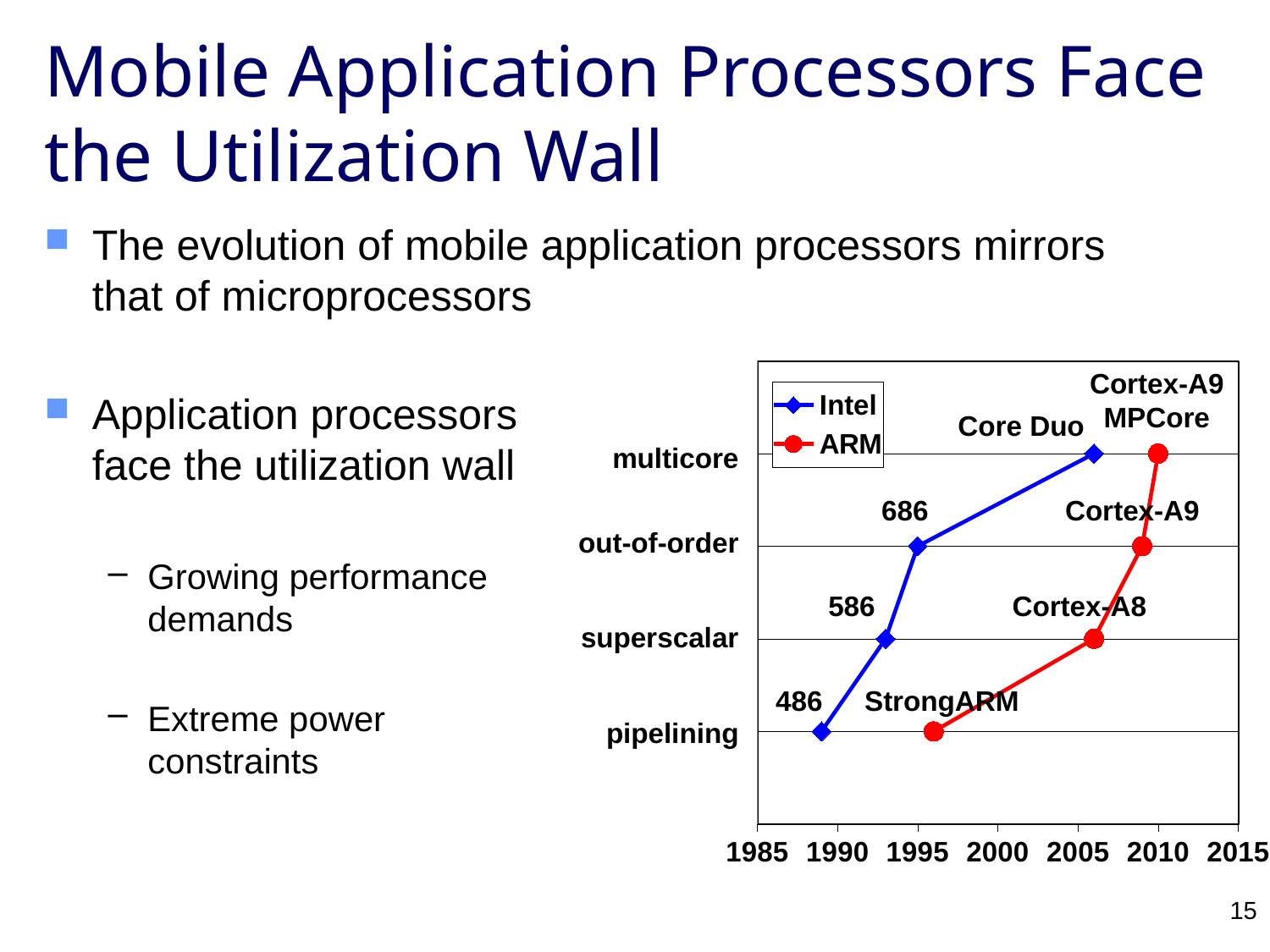
Which series reached the multicore level earlier, Intel or ARM? Intel How many data points are plotted for the ARM series? 4 Is the year for the ARM Cortex-A8 point greater or less than 2005? greater Which Intel processor is plotted at the superscalar level? 586 Is the year for the Intel 486 point greater or less than 1990? less Which Intel processor is plotted at the multicore level? Core Duo What kind of chart is shown on the slide? line chart How many series does the legend list? 2 How many data points are plotted for the Intel series? 4 Which series is drawn in red? ARM Which ARM processor is plotted at the pipelining level? StrongARM What are the two series named in the legend? Intel and ARM